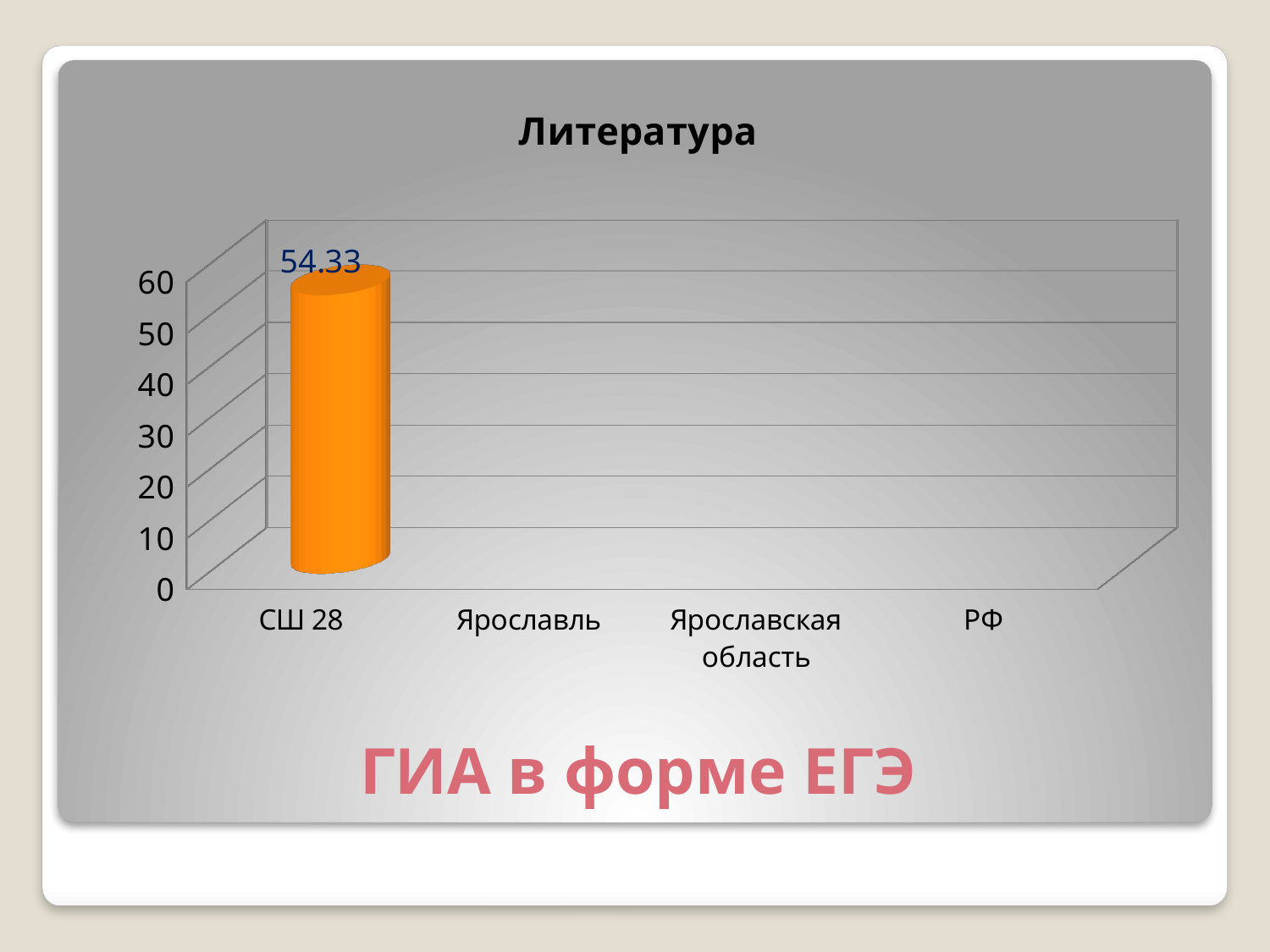
Is the value for СШ 28 greater or less than 60? less Which category is the only one with a bar plotted in the chart? СШ 28 How many categories are listed along the x axis of the chart? 4 Which category has the highest bar in the chart? СШ 28 What is the highest tick value shown on the vertical axis? 60 What is the last category label on the x axis? РФ What is the title of the chart? Литература What is the value shown for СШ 28 in the Литература chart? 54.33 Is the value for СШ 28 greater or less than 50? greater What kind of chart is shown on the slide? bar chart